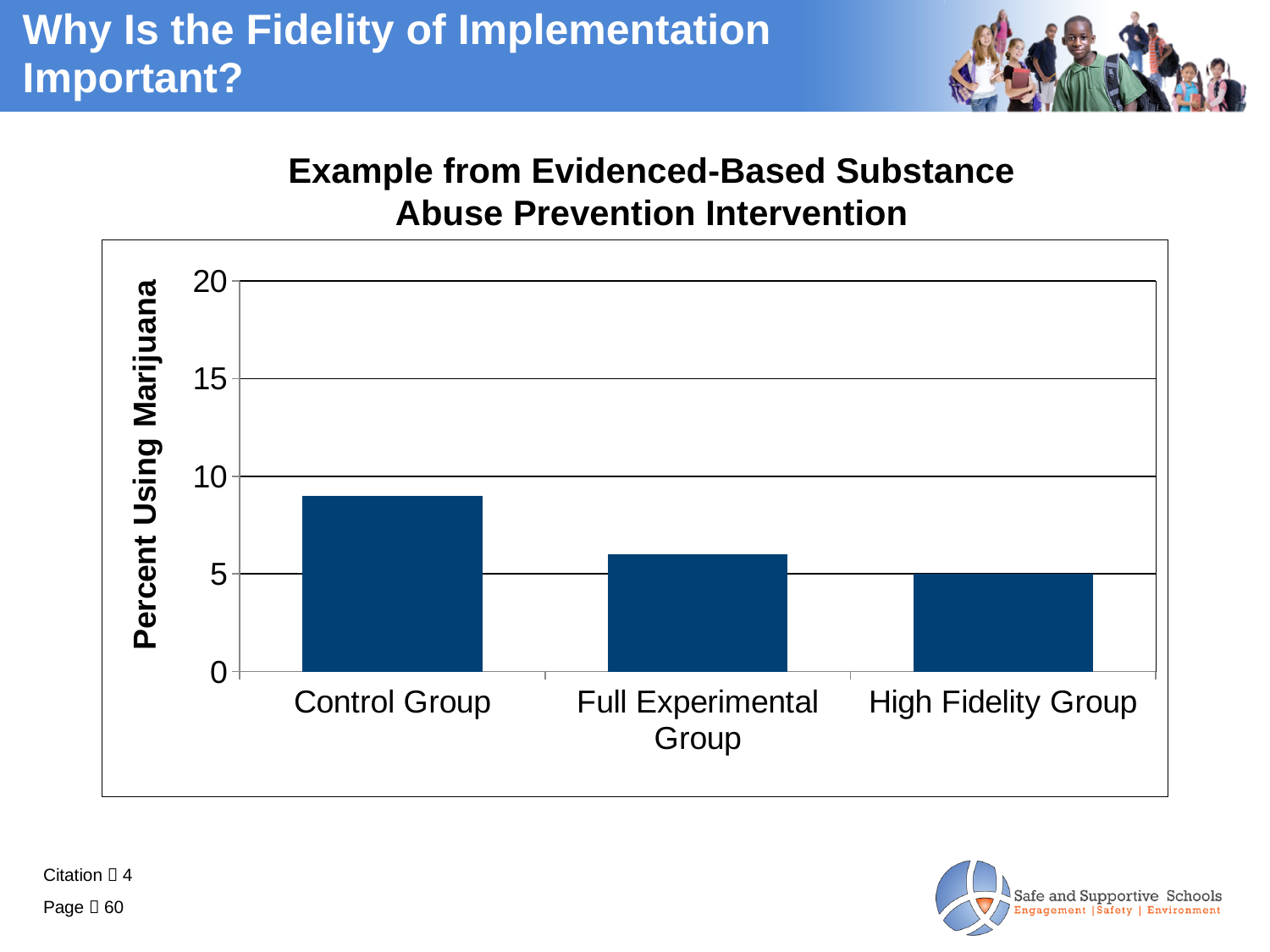
Is the value for the Full Experimental Group greater or less than 5? greater What is the label on the vertical axis of the chart? Percent Using Marijuana Which has a higher percent using marijuana, the Control Group or the Full Experimental Group? Control Group What kind of chart is shown on the slide? bar chart Which group has the highest percent using marijuana? Control Group Do the values rise or fall moving from the Control Group to the High Fidelity Group? fall Is the value for the Control Group greater or less than 10? less Which group has the lowest percent using marijuana? High Fidelity Group Is the value for the Control Group greater or less than 5? greater How many groups are plotted in the chart? 3 What is the title of the chart? Example from Evidenced-Based Substance Abuse Prevention Intervention What is the percent using marijuana for the High Fidelity Group? 5